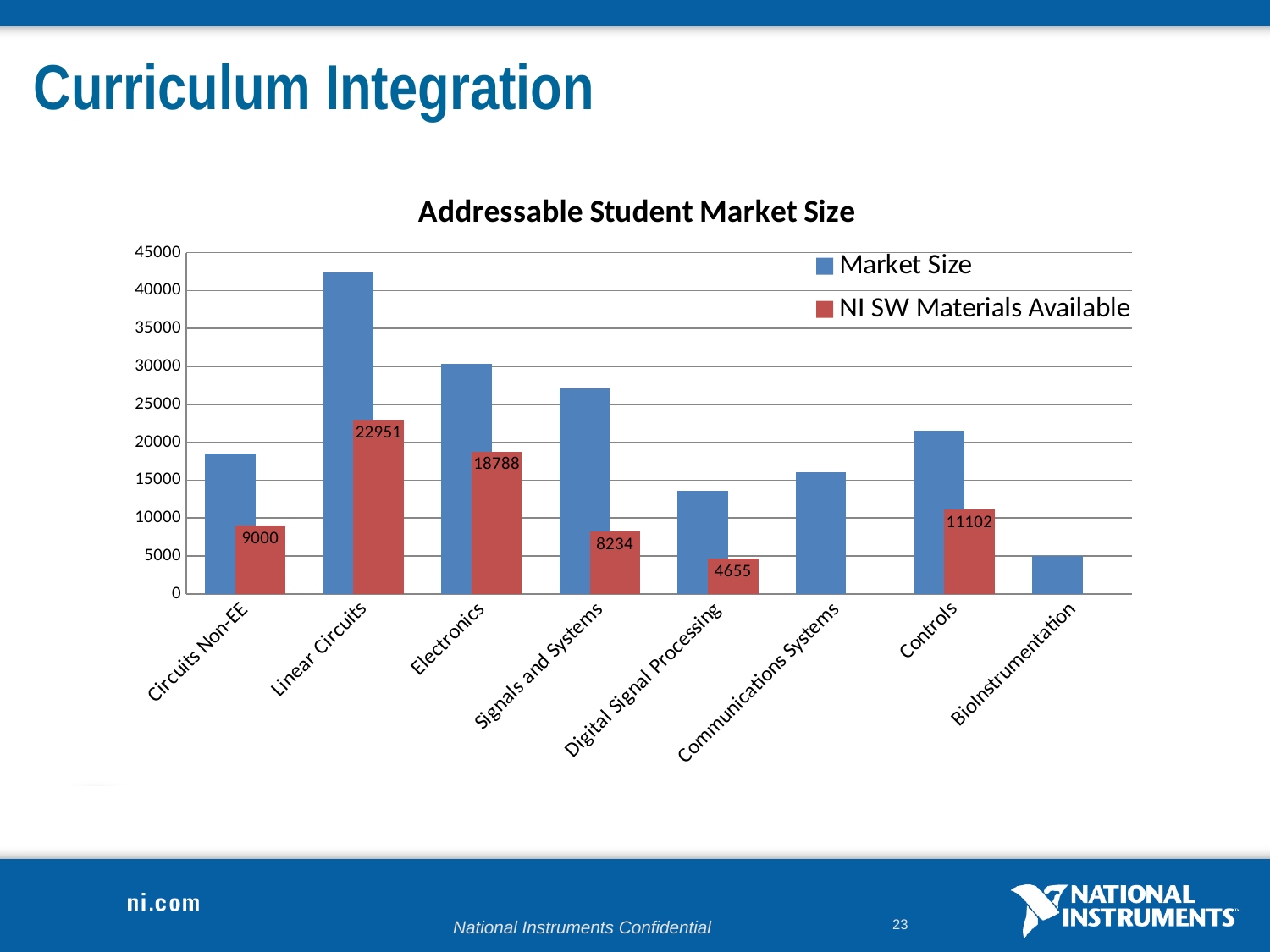
What is the NI SW Materials Available value for Digital Signal Processing? 4655 Is the Market Size for BioInstrumentation greater or less than 10000? less How many series does the legend list? 2 Which category has the lowest Market Size? BioInstrumentation How many categories are shown on the x axis? 8 Which category has the highest Market Size? Linear Circuits What is the difference between the NI SW Materials Available values for Linear Circuits and Electronics? 4163 What is the NI SW Materials Available value for Electronics? 18788 Is the Market Size for Linear Circuits greater or less than 40000? greater What is the NI SW Materials Available value for Linear Circuits? 22951 What is the difference between the NI SW Materials Available values for Controls and Circuits Non-EE? 2102 Which category has the lowest labelled NI SW Materials Available value? Digital Signal Processing